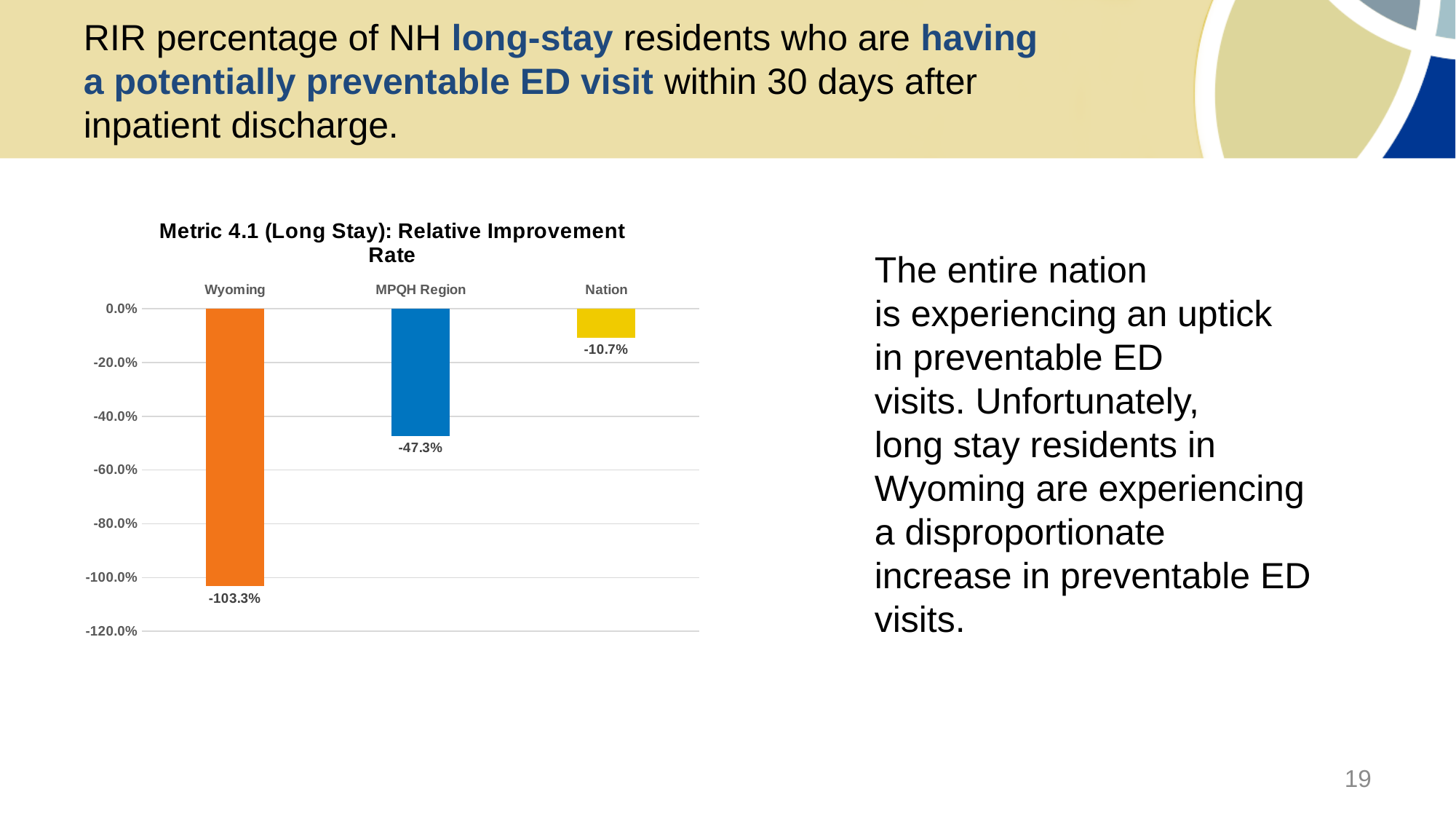
Which category has the lowest (most negative) Relative Improvement Rate? Wyoming What is the difference between the Wyoming and MPQH Region values? 56.0 percentage points Which is more negative, the value for Wyoming or the value for the Nation? Wyoming What is the Relative Improvement Rate for the Nation? -10.7% What is the title of the chart? Metric 4.1 (Long Stay): Relative Improvement Rate How many categories are shown in the chart? 3 What is the Relative Improvement Rate for Wyoming? -103.3% Is the value for Wyoming greater or less than -100.0%? less Which category has the highest (least negative) Relative Improvement Rate? Nation What is the difference between the MPQH Region and Nation values? 36.6 percentage points What is the Relative Improvement Rate for the MPQH Region? -47.3% What kind of chart is shown on the slide? Bar chart